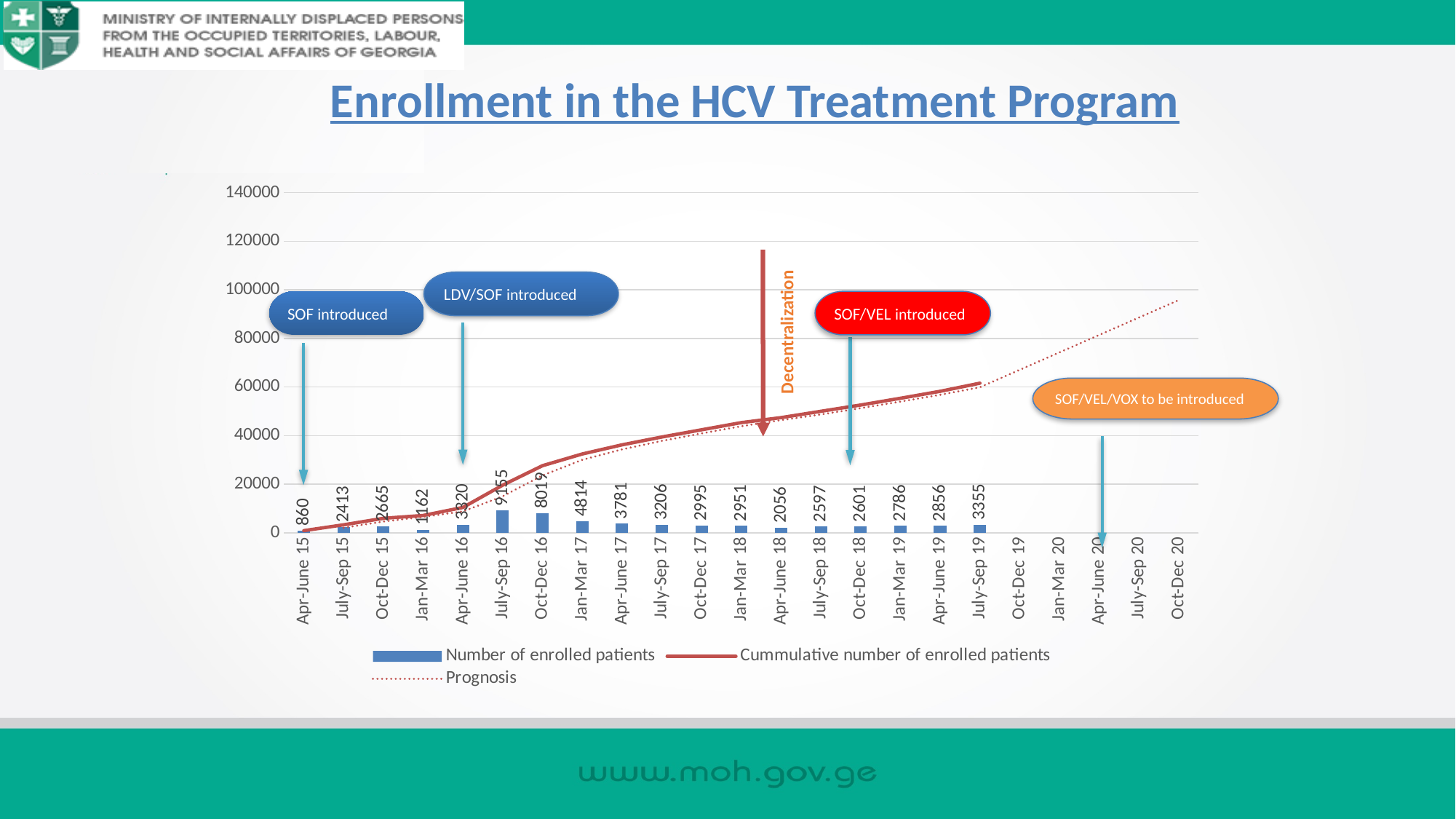
What is the difference between the number of enrolled patients in July-Sep 16 and Oct-Dec 16? 1136 Does the cumulative number of enrolled patients line rise or fall from Apr-June 15 to July-Sep 19? Rise How many series does the legend list? 3 What is the number of enrolled patients shown for Apr-June 15? 860 Which quarter has the highest number of enrolled patients? July-Sep 16 Which quarter has the lowest number of enrolled patients among the labelled bars? Apr-June 15 What kind of chart is shown on the slide? Combined bar and line chart What is the number of enrolled patients shown for July-Sep 19? 3355 Is the cumulative number of enrolled patients at July-Sep 19 greater or less than 40000? greater How many quarters have a labelled bar for the number of enrolled patients? 18 Which quarter had more enrolled patients, Jan-Mar 17 or Apr-June 17? Jan-Mar 17 How many patients were enrolled in July-Sep 16 according to the bar label? 9155